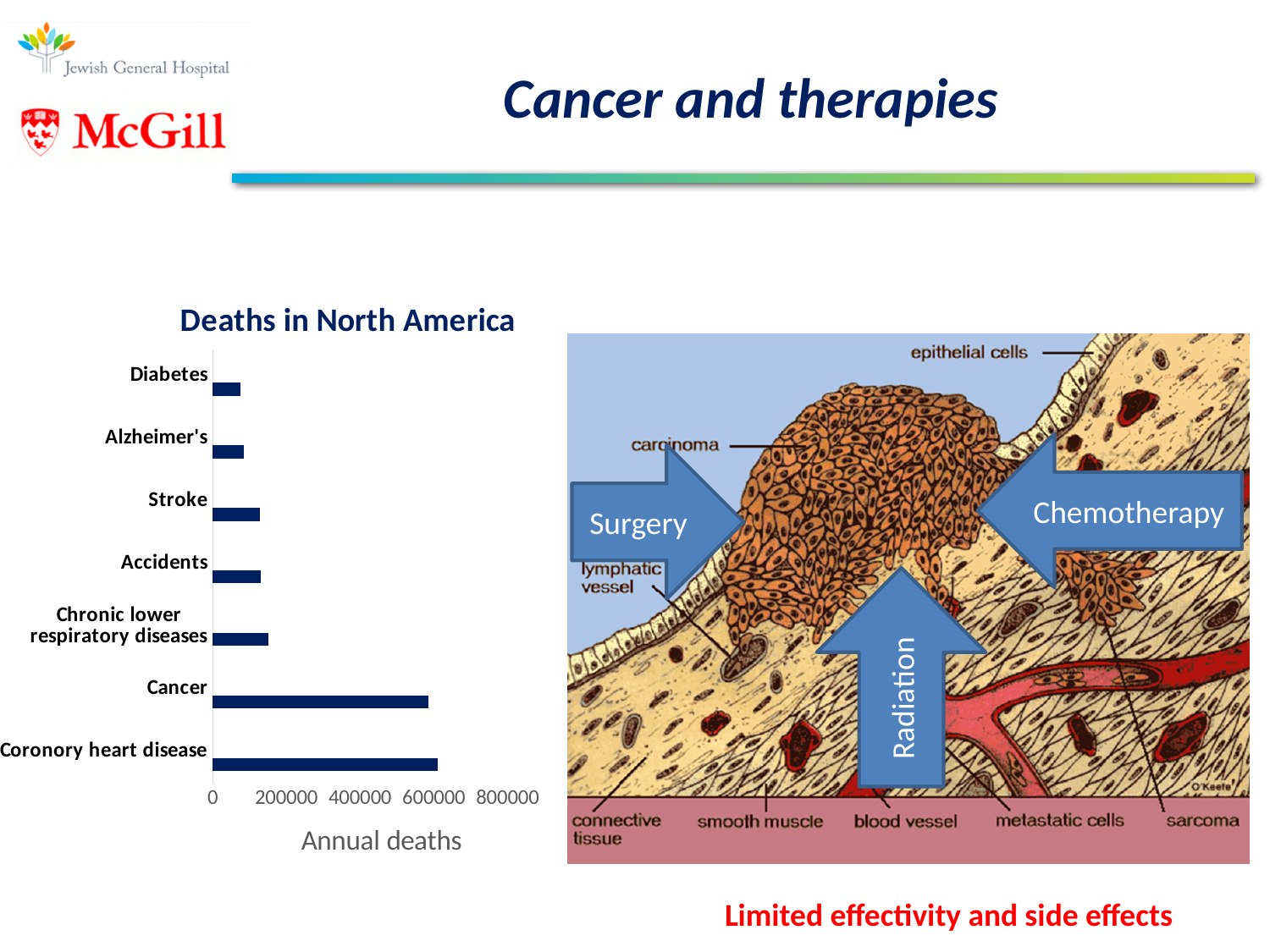
Which has more annual deaths, Accidents or Coronory heart disease? Coronory heart disease Is the value for Cancer greater or less than 800000? less Is the value for Cancer greater or less than 400000? greater How many categories are shown in the "Deaths in North America" chart? 7 Is the value for Chronic lower respiratory diseases greater or less than 400000? less What kind of chart is the "Deaths in North America" chart? bar chart Which has more annual deaths, Cancer or Stroke? Cancer Which category has the highest annual deaths in the "Deaths in North America" chart? Coronory heart disease What is the label of the horizontal axis in the "Deaths in North America" chart? Annual deaths